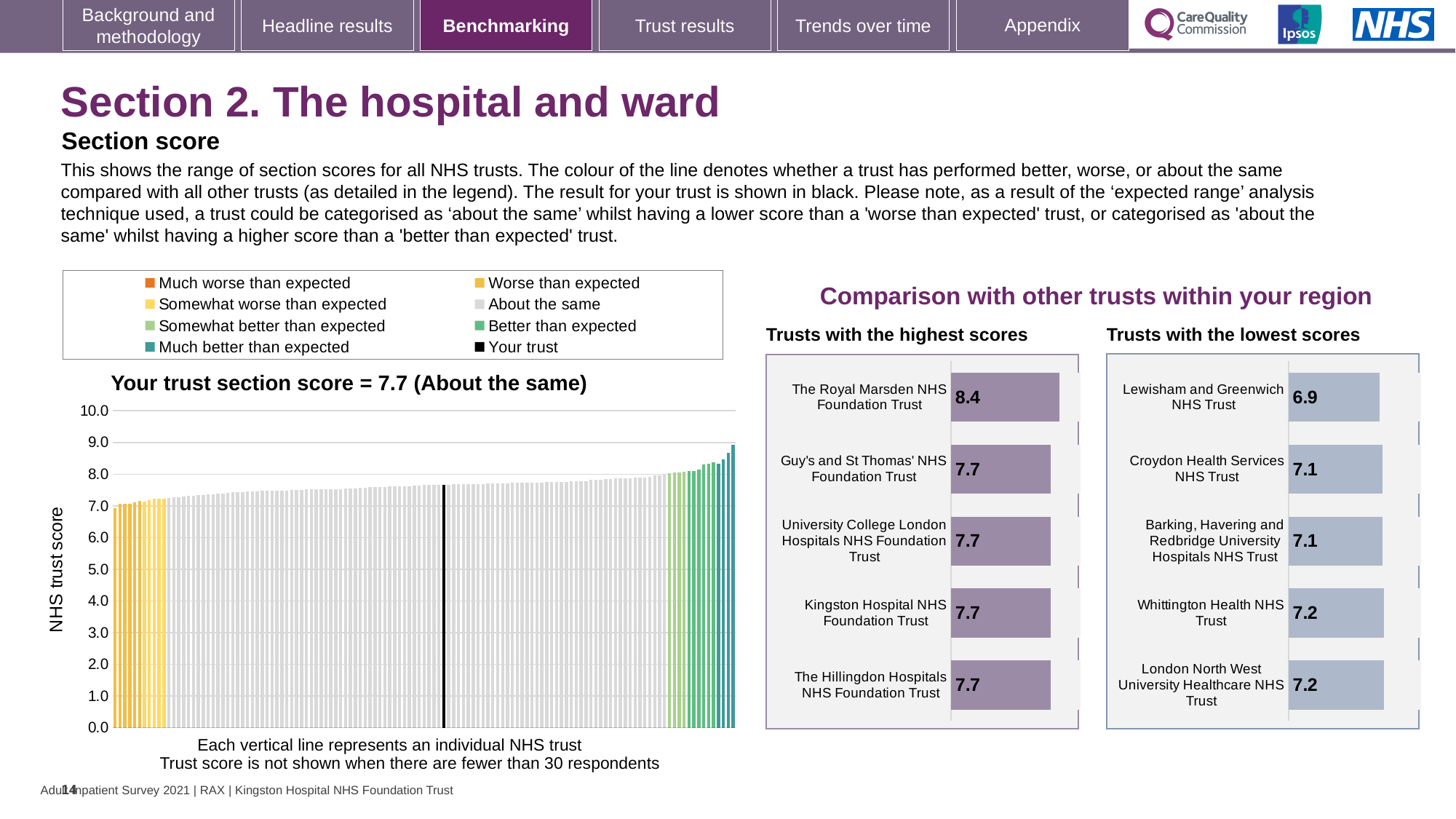
In the 'Trusts with the highest scores' chart, what is the difference between the scores of The Royal Marsden NHS Foundation Trust and Guy's and St Thomas' NHS Foundation Trust? 0.7 In the 'Trusts with the highest scores' chart, what is the score for Kingston Hospital NHS Foundation Trust? 7.7 How many trusts are listed in the 'Trusts with the lowest scores' chart? 5 In the 'Trusts with the lowest scores' chart, which trust has the lowest score? Lewisham and Greenwich NHS Trust In the 'Trusts with the lowest scores' chart, what is the difference between the scores of London North West University Healthcare NHS Trust and Lewisham and Greenwich NHS Trust? 0.3 In the main 'Your trust section score' chart, is the value of the tallest bar greater or less than 8.0? greater In the 'Trusts with the highest scores' chart, which trust has the highest score? The Royal Marsden NHS Foundation Trust In the 'Trusts with the lowest scores' chart, which has the larger score: Croydon Health Services NHS Trust or Lewisham and Greenwich NHS Trust? Croydon Health Services NHS Trust In the 'Trusts with the highest scores' chart, what is the score for The Royal Marsden NHS Foundation Trust? 8.4 In the 'Trusts with the lowest scores' chart, what is the score for Lewisham and Greenwich NHS Trust? 6.9 How many entries does the legend above the main 'Your trust section score' chart list? 8 In the 'Trusts with the lowest scores' chart, what is the score for Whittington Health NHS Trust? 7.2